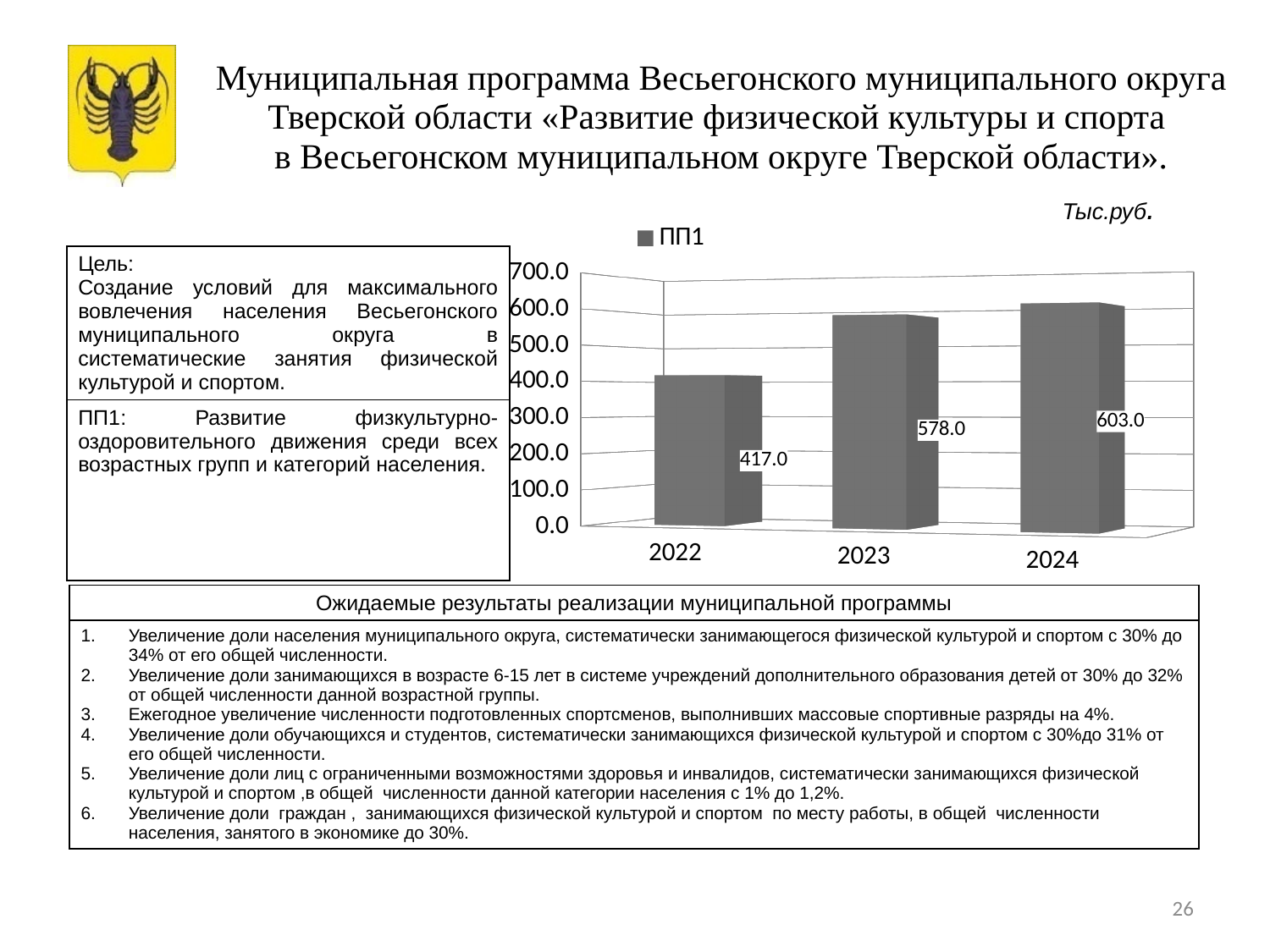
What is the value for 2024? 603.0 Which is larger, the value for 2023 or the value for 2022? 2023 What is the difference between the values for 2023 and 2022? 161.0 What is the value for 2023? 578.0 How many years are shown on the x axis? 3 Which year has the highest value? 2024 Do the values rise or fall from 2022 to 2024? rise Which year has the lowest value? 2022 What kind of chart is shown? bar chart What is the difference between the values for 2024 and 2022? 186.0 What is the value for 2022? 417.0 How many series does the legend list? 1